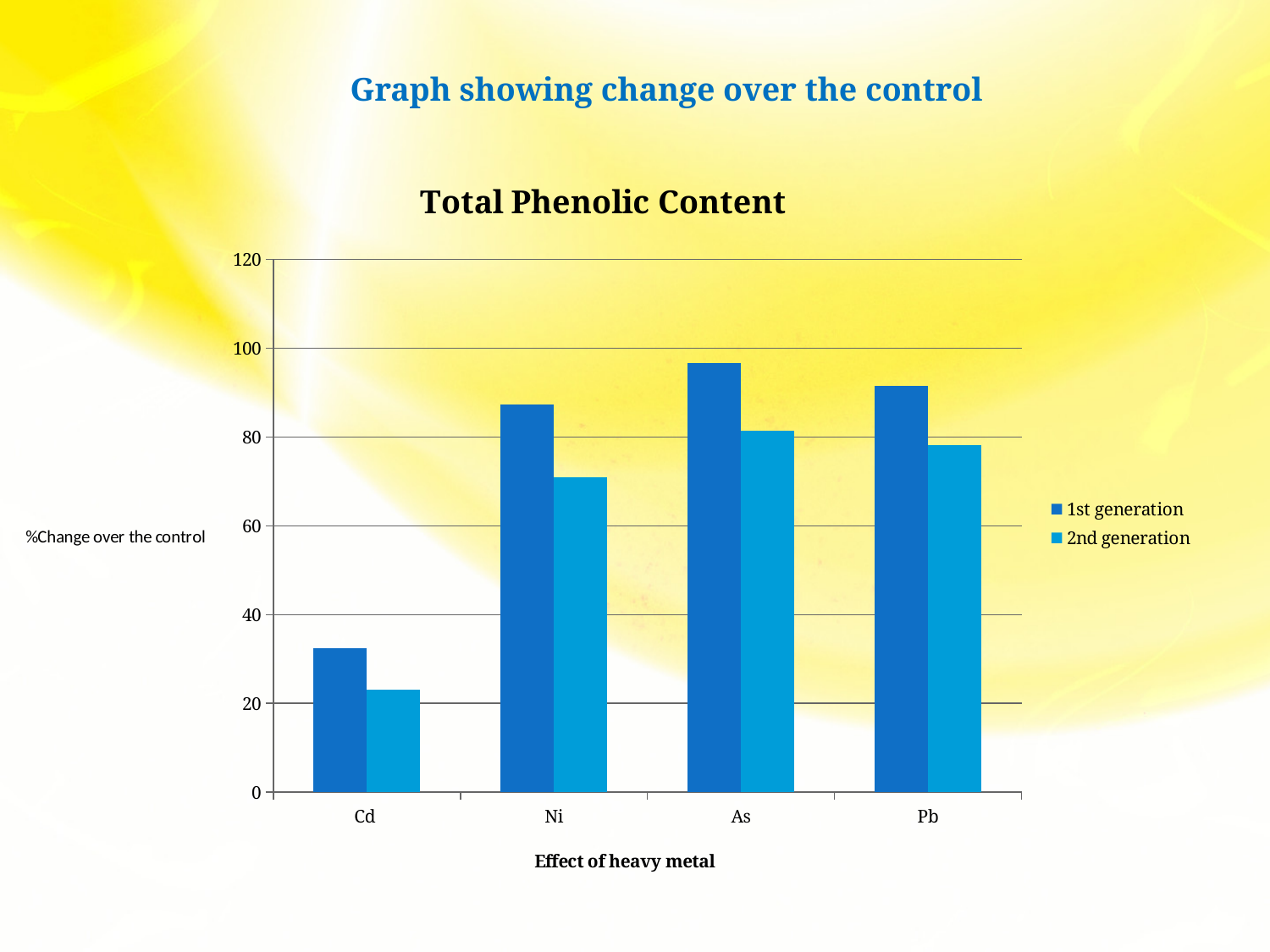
For Ni, which is larger: the 1st generation value or the 2nd generation value? 1st generation How many series does the legend list? 2 Is the 1st generation value for Pb greater or less than 100? less What kind of chart is shown on the slide? bar chart How many heavy metal categories are shown on the x axis? 4 What is the title of the chart? Total Phenolic Content What is the label of the x axis? Effect of heavy metal Which heavy metal has the highest 1st generation value? As Which heavy metal has the lowest 2nd generation value? Cd Is the 1st generation value for Cd greater or less than 40? less Which heavy metal has the lowest 1st generation value? Cd